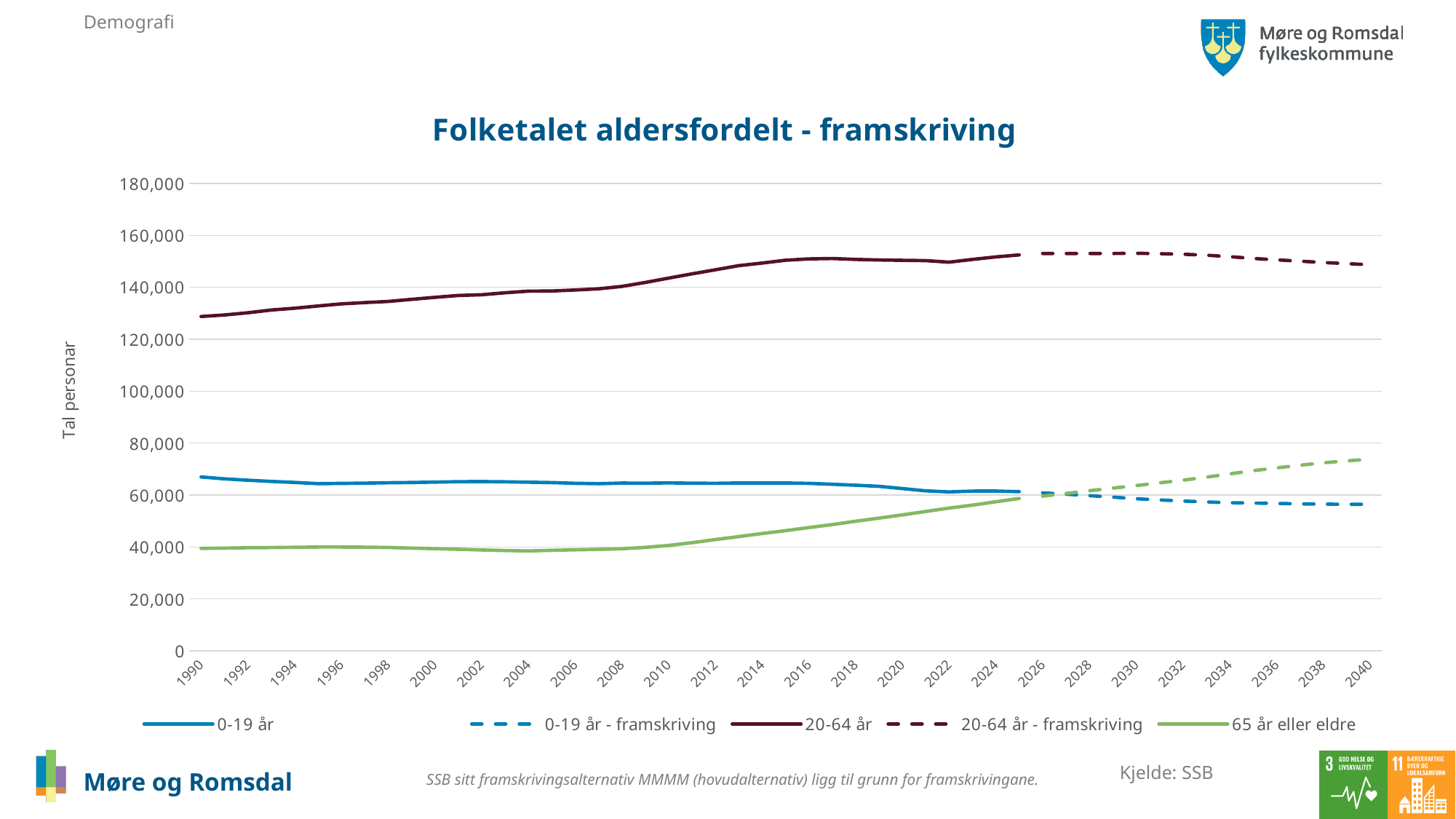
Which series has the highest values across the whole chart? 20-64 år Is the value for 20-64 år in 1990 greater or less than 120,000? greater How many series does the legend list? 5 Does the 0-19 år - framskriving series rise or fall between 2026 and 2040? fall Is the value for 0-19 år - framskriving in 2040 greater or less than 60,000? less Is the value for 0-19 år in 1990 greater or less than 60,000? greater Does the 20-64 år series rise or fall between 1990 and 2024? rise What is the title of the chart? Folketalet aldersfordelt - framskriving What kind of chart is shown on the slide? Line chart In 2000, which is larger: 0-19 år or 65 år eller eldre? 0-19 år What is the label on the vertical axis? Tal personar